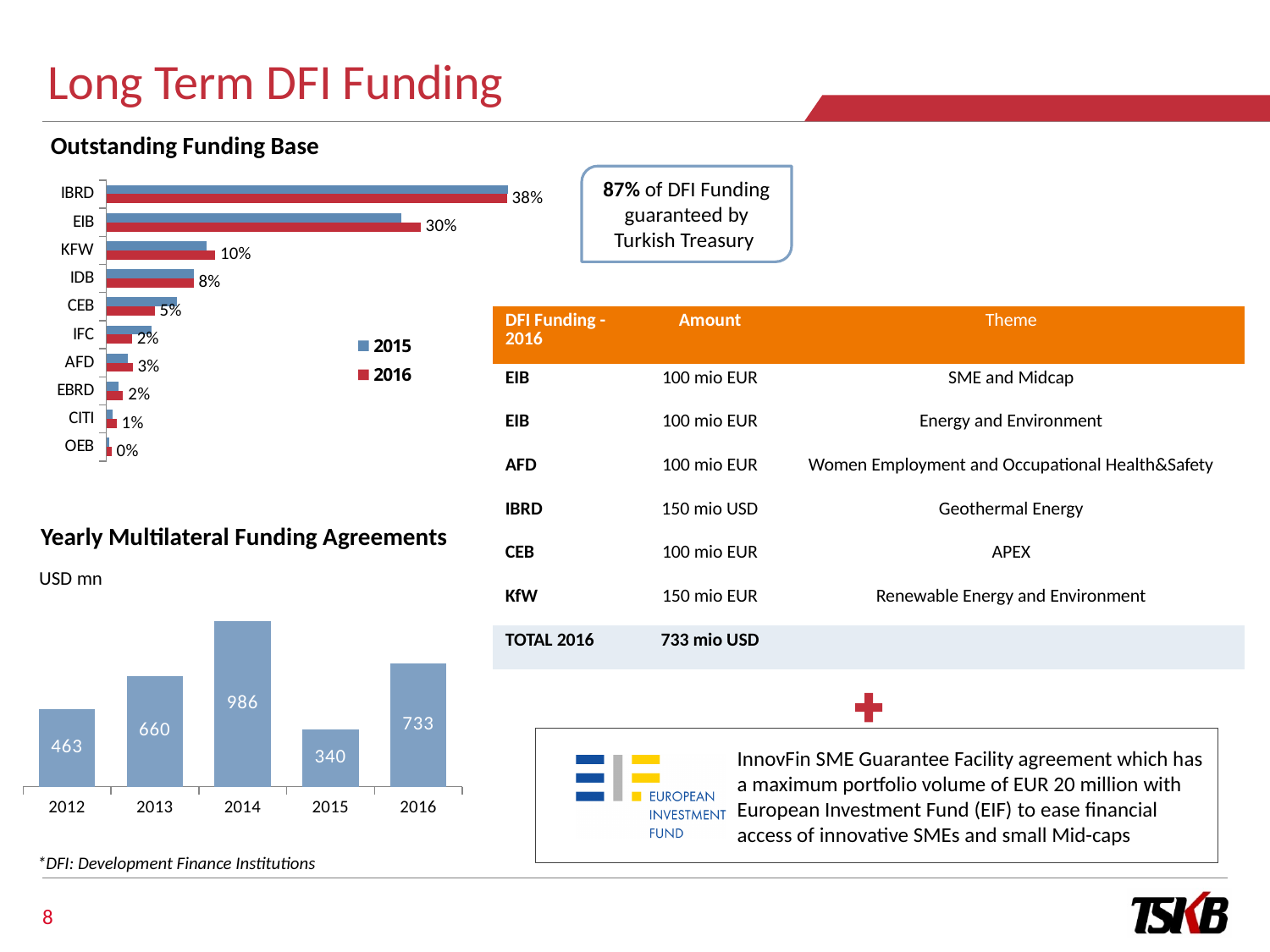
In the Outstanding Funding Base chart, how many institutions are shown on the axis? 10 What kind of chart is the Yearly Multilateral Funding Agreements chart? Bar chart In the Outstanding Funding Base chart, what is the 2016 value for IBRD? 38% In the Outstanding Funding Base chart, which institution has the highest 2016 share? IBRD In the Yearly Multilateral Funding Agreements chart, what is the value for 2014? 986 In the Outstanding Funding Base chart, how many series does the legend list? 2 In the Outstanding Funding Base chart, what is the 2016 value for EIB? 30% In the Outstanding Funding Base chart, what is the difference between the 2016 values for IBRD and EIB? 8% In the Outstanding Funding Base chart, what is the 2016 value for KFW? 10% In the Yearly Multilateral Funding Agreements chart, which year has the lowest value? 2015 In the Yearly Multilateral Funding Agreements chart, which is larger, the value for 2013 or the value for 2016? 2016 In the Yearly Multilateral Funding Agreements chart, what is the difference between the 2016 and 2015 values? 393